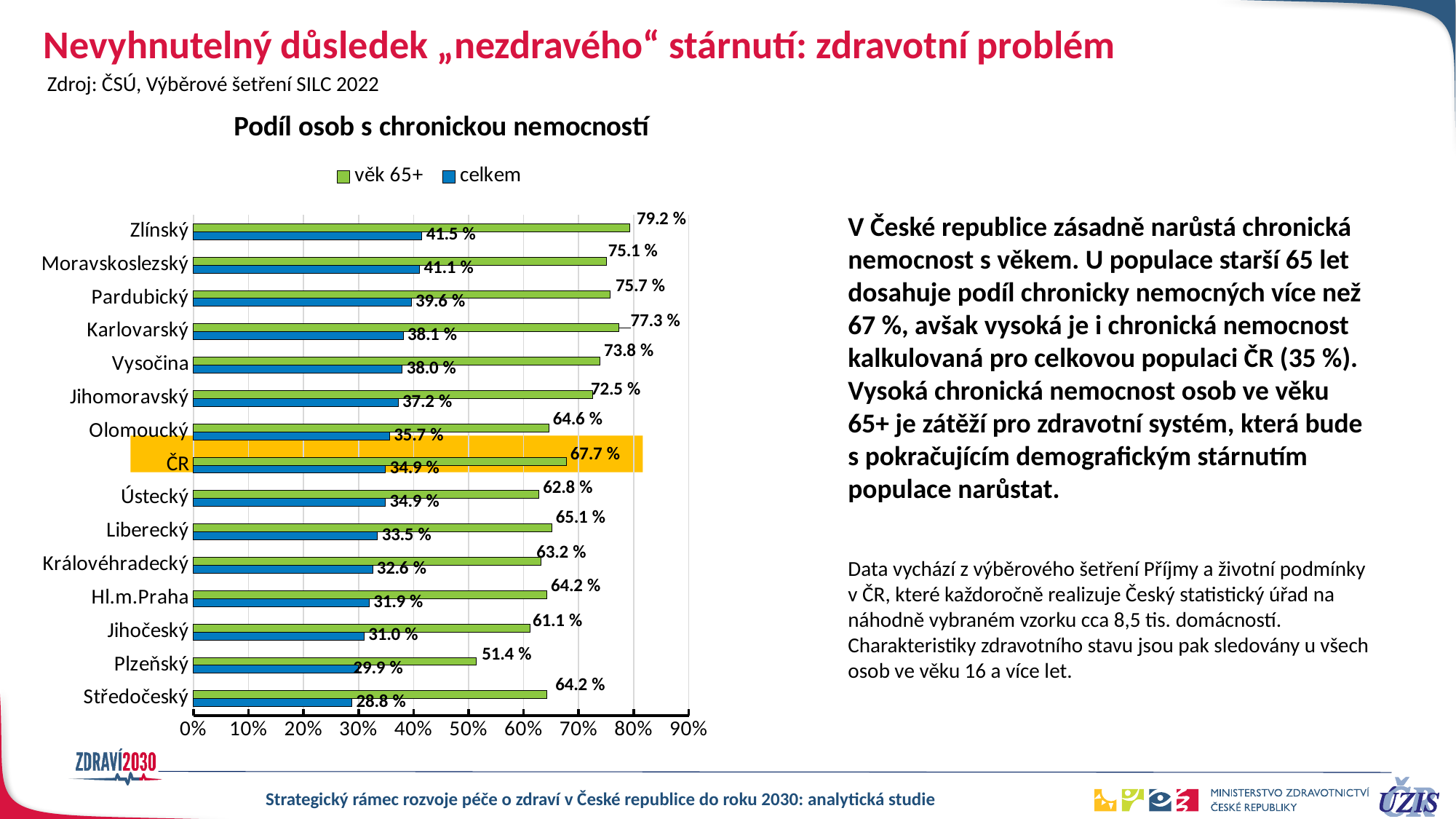
Which category has the lowest value for věk 65+? Plzeňský What is the value for věk 65+ for ČR? 67.7 % What is the title of the chart? Podíl osob s chronickou nemocností How many series does the legend of the chart list? 2 What is the value for věk 65+ in the Zlínský region? 79.2 % What is the value for celkem in the Středočeský region? 28.8 % What is the difference between the věk 65+ and celkem values for the Zlínský region? 37.7 % How many categories (regions including ČR) are shown on the chart? 15 What kind of chart is shown on the slide? bar chart Which category has the highest value for celkem? Zlínský Is the celkem value for Jihočeský greater or less than 40%? less Which is larger, the věk 65+ value for Karlovarský or for Pardubický? Karlovarský